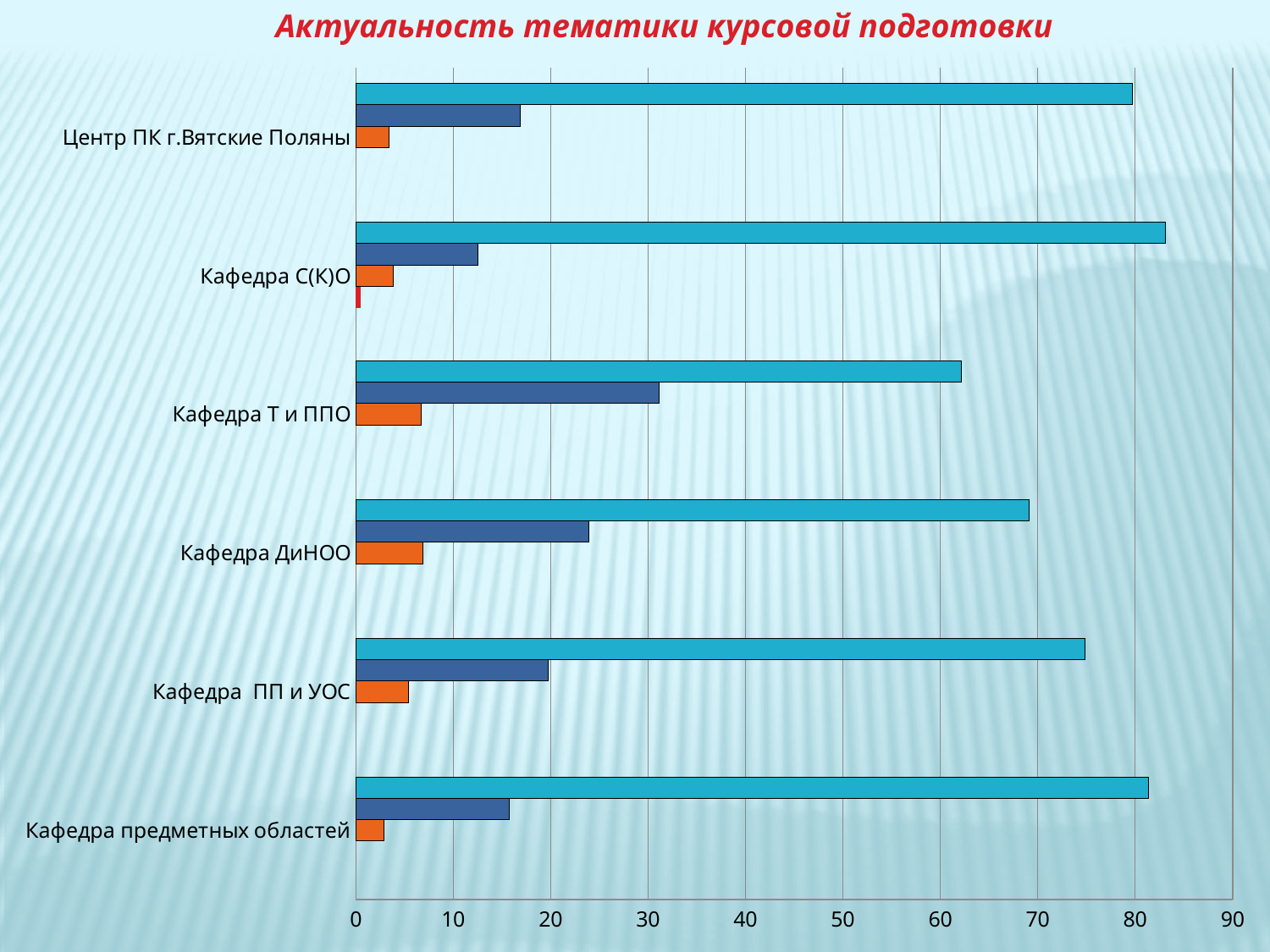
Is the light blue value for Кафедра ПП и УОС greater or less than 70? greater For the dark blue series, which is larger: Кафедра Т и ППО or Центр ПК г.Вятские Поляны? Кафедра Т и ППО What is the title of the chart on the slide? Актуальность тематики курсовой подготовки Which category has the lowest value for the light blue series? Кафедра Т и ППО Is the light blue value for Кафедра Т и ППО greater or less than 70? less Which category has the highest value for the dark blue series? Кафедра Т и ППО For the light blue series, which is larger: Кафедра Т и ППО or Кафедра ДиНОО? Кафедра ДиНОО Is the dark blue value for Кафедра ДиНОО greater or less than 20? greater What kind of chart is shown on the slide? bar chart How many categories (departments) are shown on the chart? 6 Which category has the lowest value for the dark blue series? Кафедра С(К)О What is the highest value shown on the horizontal axis of the chart? 90